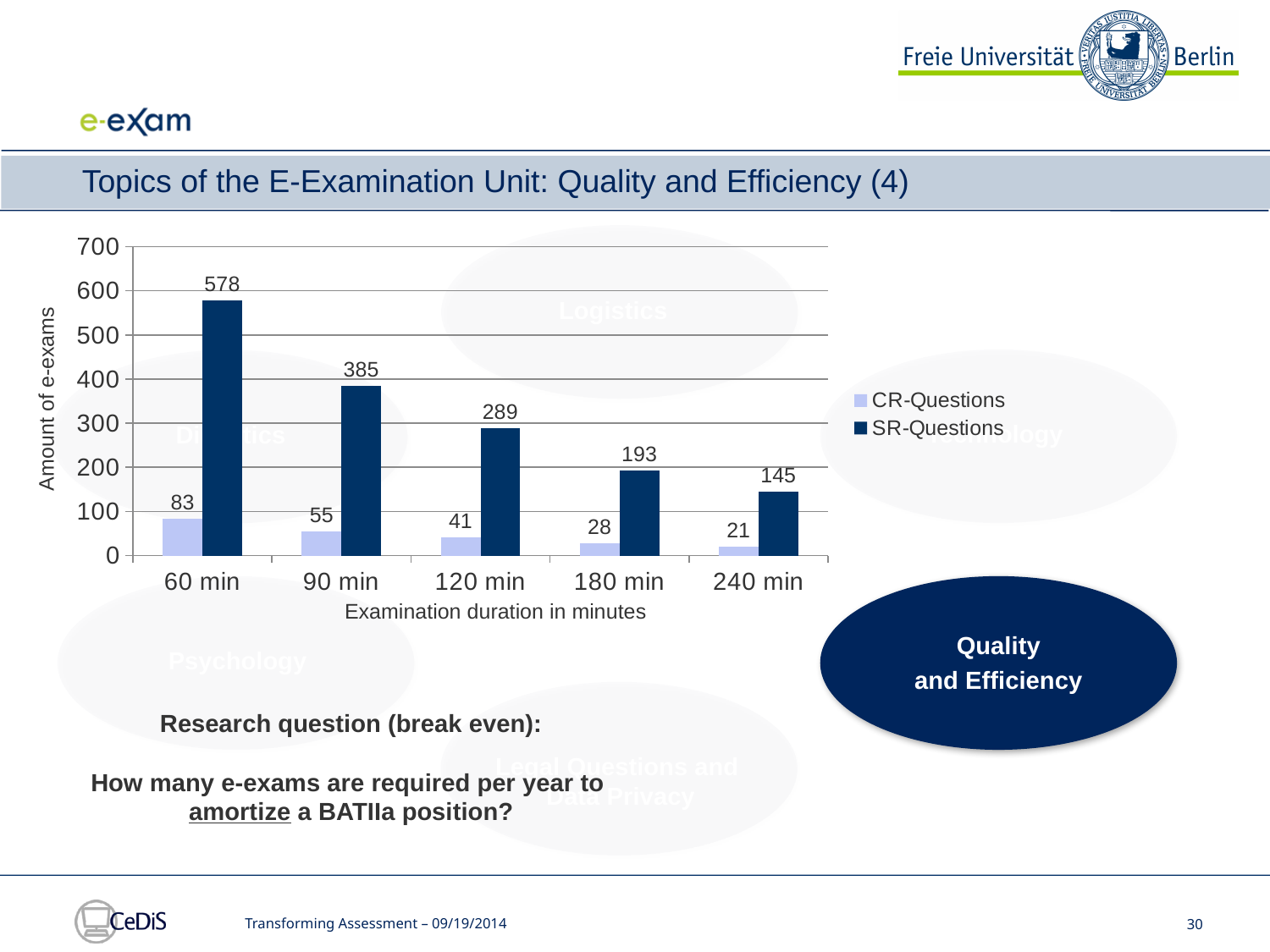
What is the difference between SR-Questions and CR-Questions at 90 min? 330 What is the value for CR-Questions at 120 min? 41 What is the value for SR-Questions at 60 min? 578 Which examination duration has the lowest value for CR-Questions? 240 min Do the SR-Questions values rise or fall as examination duration increases? fall How many examination duration categories are shown on the x axis? 5 How many series does the legend list? 2 What is the value for SR-Questions at 240 min? 145 Which examination duration has the highest value for SR-Questions? 60 min Is the value for SR-Questions at 120 min greater or less than 200? greater Which is larger at 180 min: SR-Questions or CR-Questions? SR-Questions What kind of chart is shown on the slide? bar chart